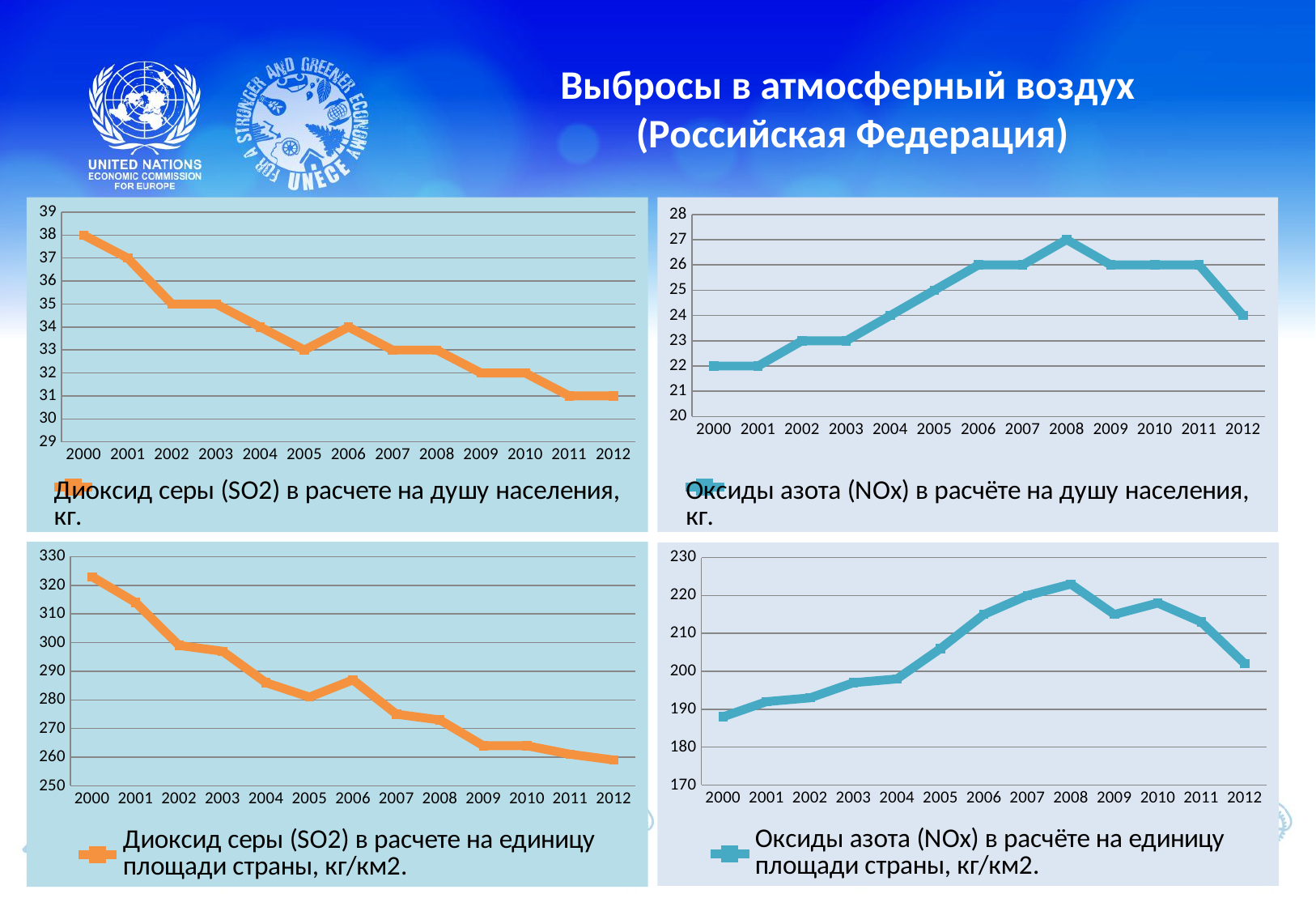
In the top-left chart (sulphur dioxide per capita), which year has the highest value? 2000 In the top-left chart (sulphur dioxide per capita), what is the value for 2000? 38 In the top-left chart (sulphur dioxide per capita), what is the difference between the 2000 value and the 2012 value? 7 In the bottom-right chart (nitrogen oxides per unit area), which is larger, the value for 2008 or the value for 2000? 2008 In the top-right chart (nitrogen oxides per capita), what is the difference between the 2008 value and the 2000 value? 5 In the top-right chart (nitrogen oxides per capita), which year has the highest value? 2008 In the top-right chart (nitrogen oxides per capita), what is the value for 2008? 27 What kind of chart is the top-right chart (nitrogen oxides per capita)? line chart In the top-left chart (sulphur dioxide per capita), what is the value for 2012? 31 In the bottom-left chart (sulphur dioxide per unit area), is the value for 2000 greater or less than 320? greater How many years are plotted on the x axis of the bottom-left chart (sulphur dioxide per unit area)? 13 In the bottom-right chart (nitrogen oxides per unit area), is the value for 2012 greater or less than 210? less